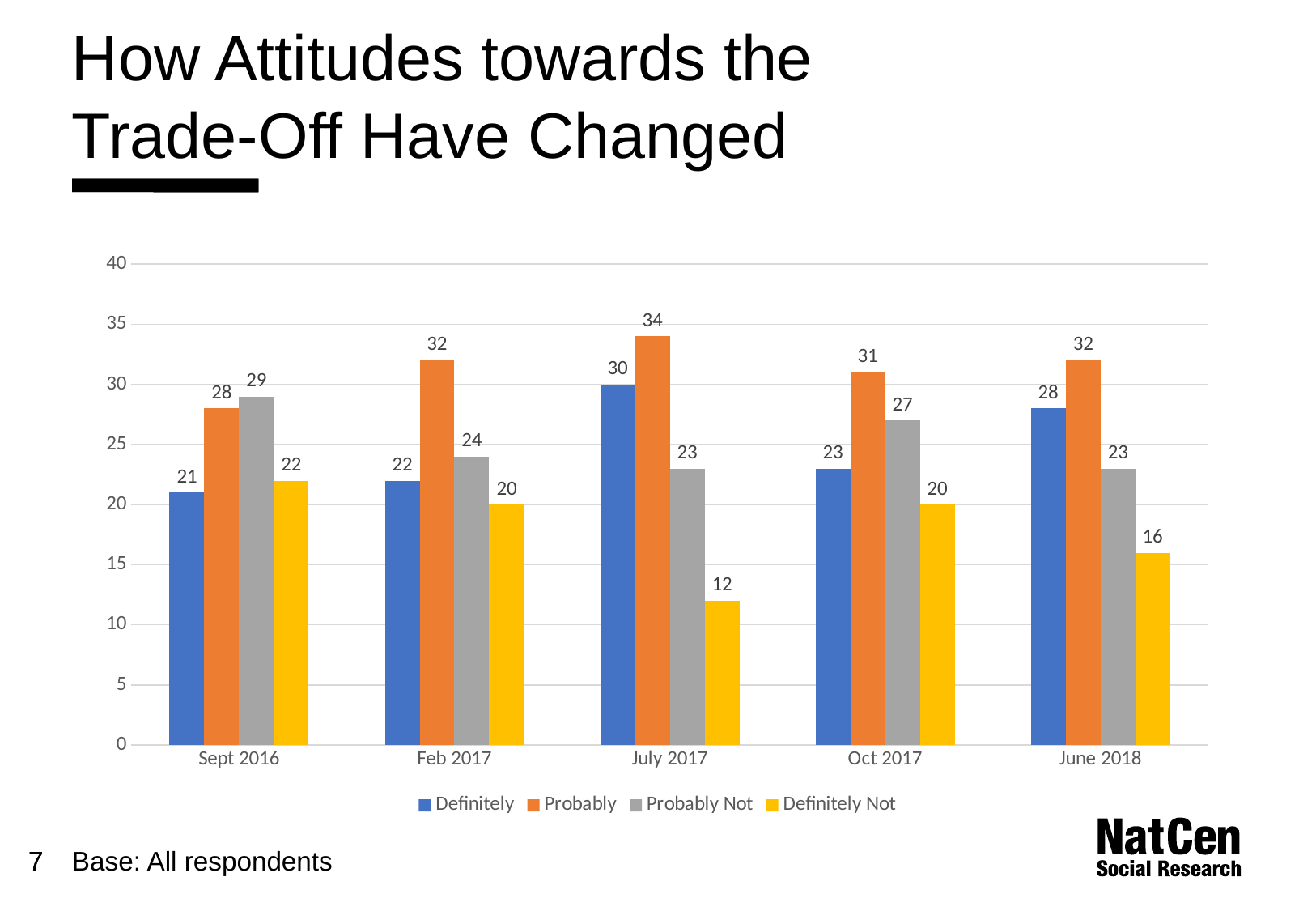
In which period is the Definitely Not value lowest? July 2017 How many series does the legend list? 4 How many time periods are shown on the x axis? 5 What kind of chart is shown on the slide? Bar chart Does the Definitely Not value rise or fall from Sept 2016 to July 2017? Fall What is the difference between the Probably and Definitely values in Feb 2017? 10 What is the value for Probably Not in Oct 2017? 27 What is the value for Definitely Not in June 2018? 16 Which is larger in Sept 2016, Probably or Probably Not? Probably Not In which period is the Definitely value highest? July 2017 What is the value for Probably in July 2017? 34 Which colour represents the Probably Not series? Grey